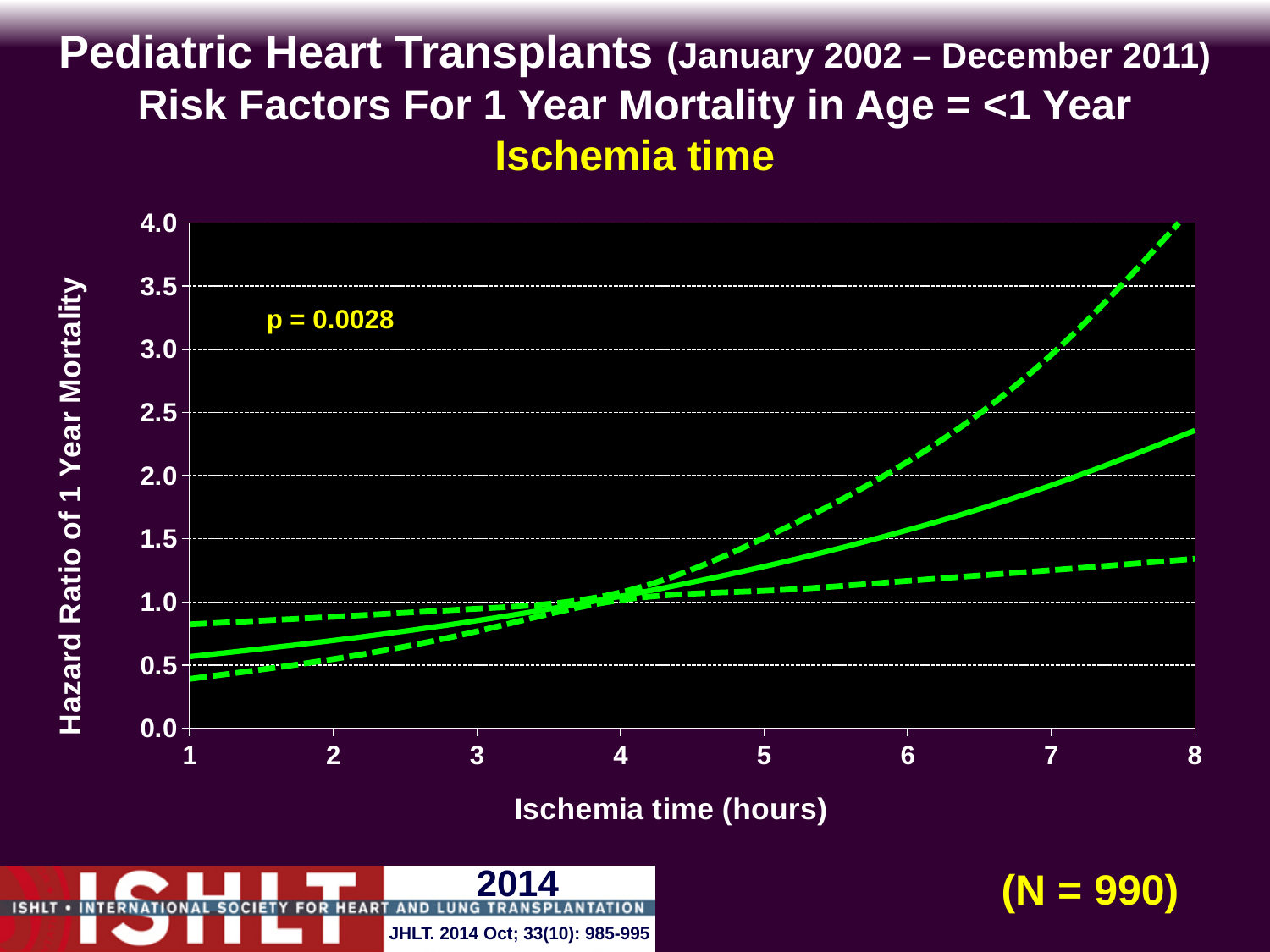
Is the hazard ratio (solid line) at 5 hours of ischemia time greater or less than 1.0? greater Is the hazard ratio (solid line) at 8 hours of ischemia time greater or less than 2.0? greater What is the p-value shown on the chart? p = 0.0028 How many lines are plotted on the chart? 3 Is the hazard ratio (solid line) at 1 hour of ischemia time greater or less than 1.0? less What is the label of the x axis? Ischemia time (hours) Does the hazard ratio of 1 year mortality (solid line) rise or fall as ischemia time increases from 1 to 8 hours? rise What is the highest value shown on the y axis? 4.0 What kind of chart is shown on the slide? line chart